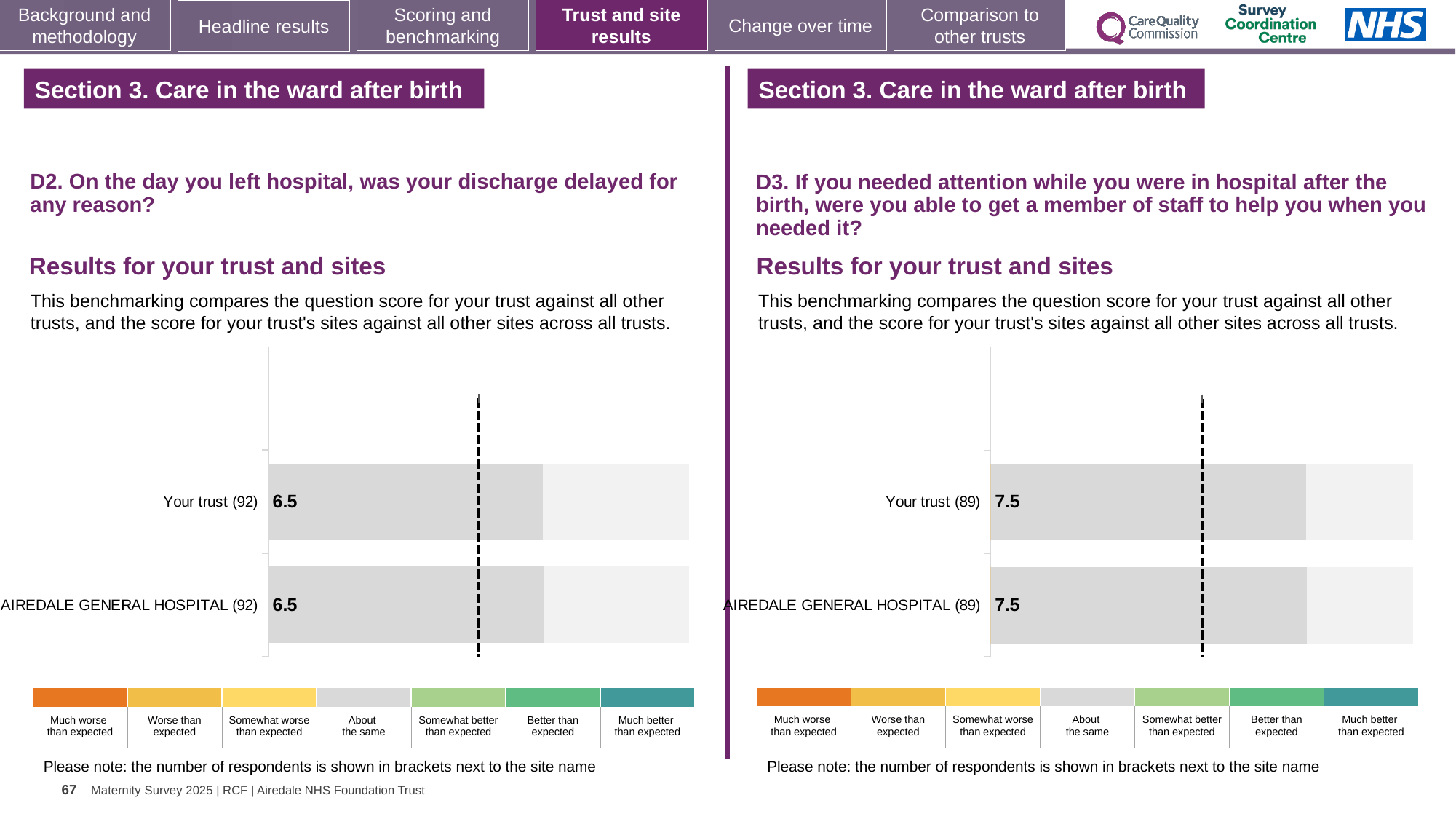
In the left chart (D2, discharge delayed), what is the score for Your trust? 6.5 In the right chart (D3, able to get a member of staff to help), what is the score for Your trust? 7.5 How many bars are plotted in the left chart (D2)? 2 How many bars are plotted in the right chart (D3)? 2 In the left chart (D2, discharge delayed), what is the score for Airedale General Hospital? 6.5 What is the difference between the Your trust score in the right chart (D3) and the Your trust score in the left chart (D2)? 1.0 In the left chart (D2), how many respondents are shown in brackets next to Your trust? 92 In the left chart (D2), what is the difference between the score for Your trust and the score for Airedale General Hospital? 0 What kind of chart is used on the left side of the slide (D2)? Bar chart In the right chart (D3), how many respondents are shown in brackets next to Airedale General Hospital? 89 In the right chart (D3, able to get a member of staff to help), what is the score for Airedale General Hospital? 7.5